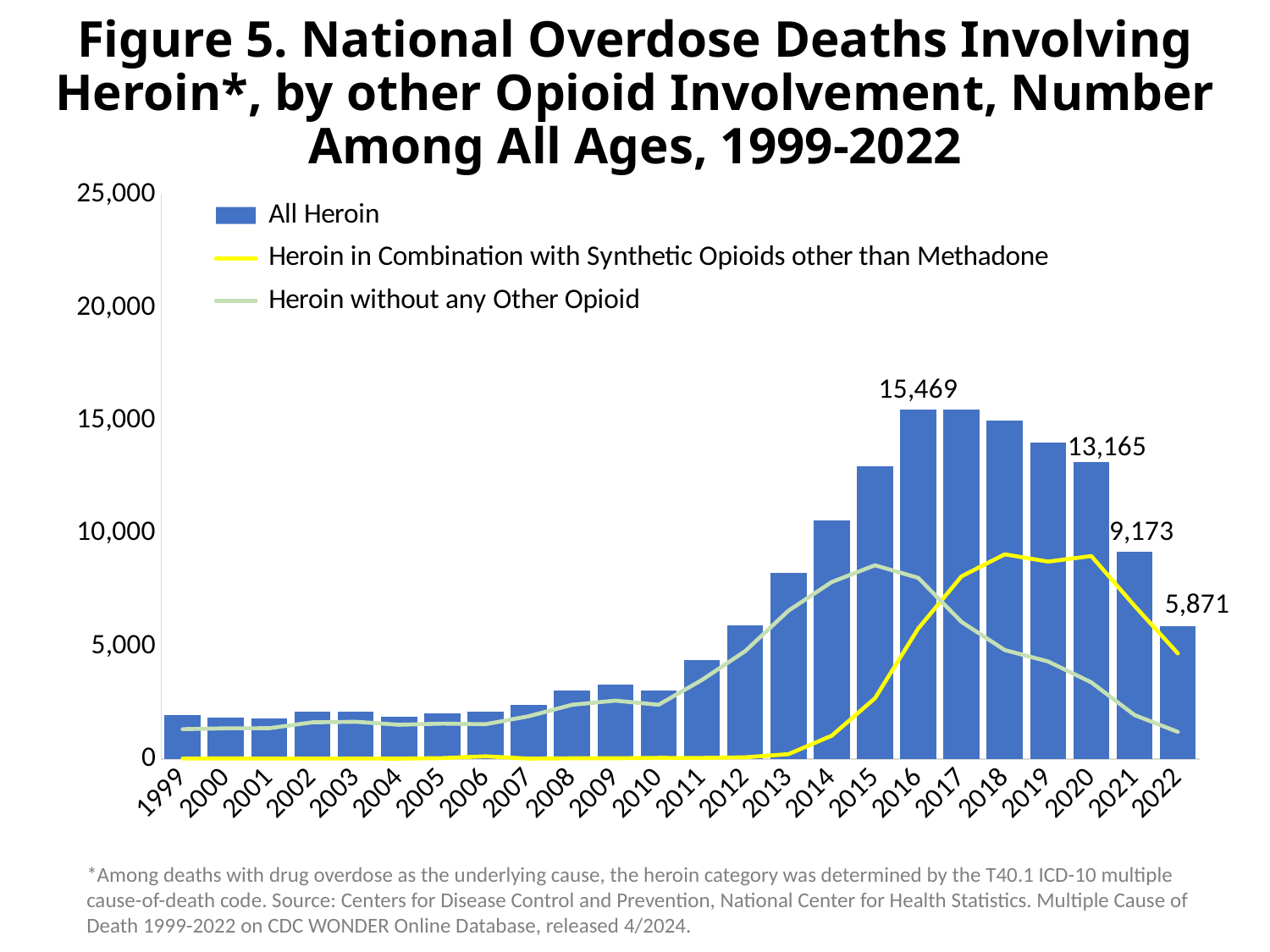
What is the value for All Heroin in 2021? 9,173 How many series does the legend list? 3 Is the All Heroin value for 2014 greater or less than 10,000? greater What type of chart is shown on the slide? Bar chart with line series Which is larger, the All Heroin value for 2020 or for 2021? 2020 What is the value for All Heroin in 2020? 13,165 Is the All Heroin value for 2011 greater or less than 5,000? less What is the value for All Heroin in 2016? 15,469 What is the difference between the All Heroin values for 2021 and 2022? 3,302 What is the value for All Heroin in 2022? 5,871 How many years are shown on the x axis? 24 What is the difference between the All Heroin values for 2020 and 2021? 3,992